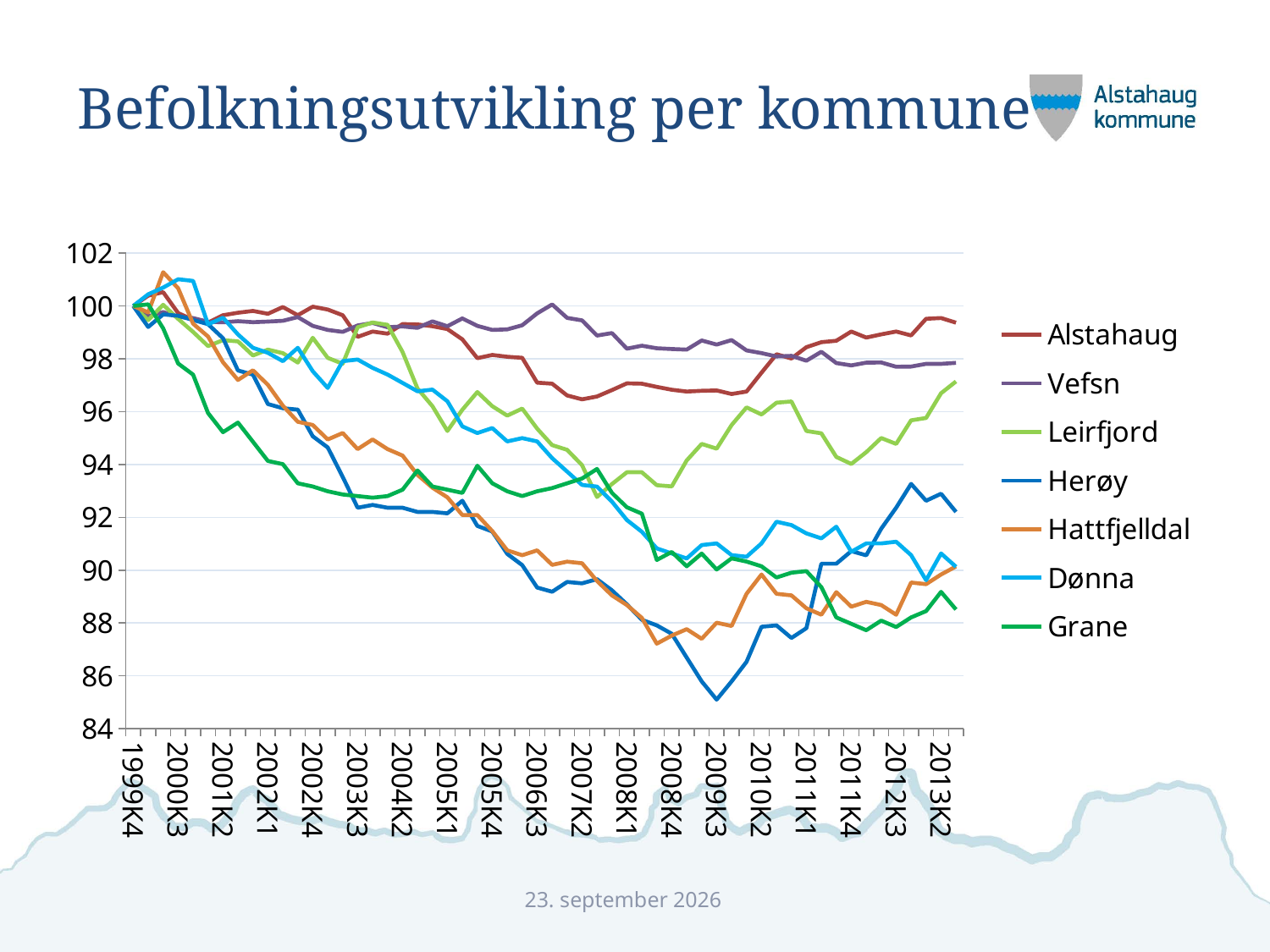
Is the value for Hattfjelldal at 2008K4 greater or less than 88? less Is the value for Leirfjord at 2013K2 greater or less than 98? less Which series has the lowest value at 2009K3? Herøy What kind of chart is shown on the slide? Line chart What is the title of the slide containing the chart? Befolkningsutvikling per kommune Which series has the highest value at 2013K2? Alstahaug How many series does the legend list? 7 Is the value for Herøy at 2009K3 greater or less than 86? less Does the Herøy line rise or fall from 1999K4 to 2009K3? fall Which series is listed last in the legend? Grane At 2013K2, which is larger: the value for Alstahaug or the value for Grane? Alstahaug